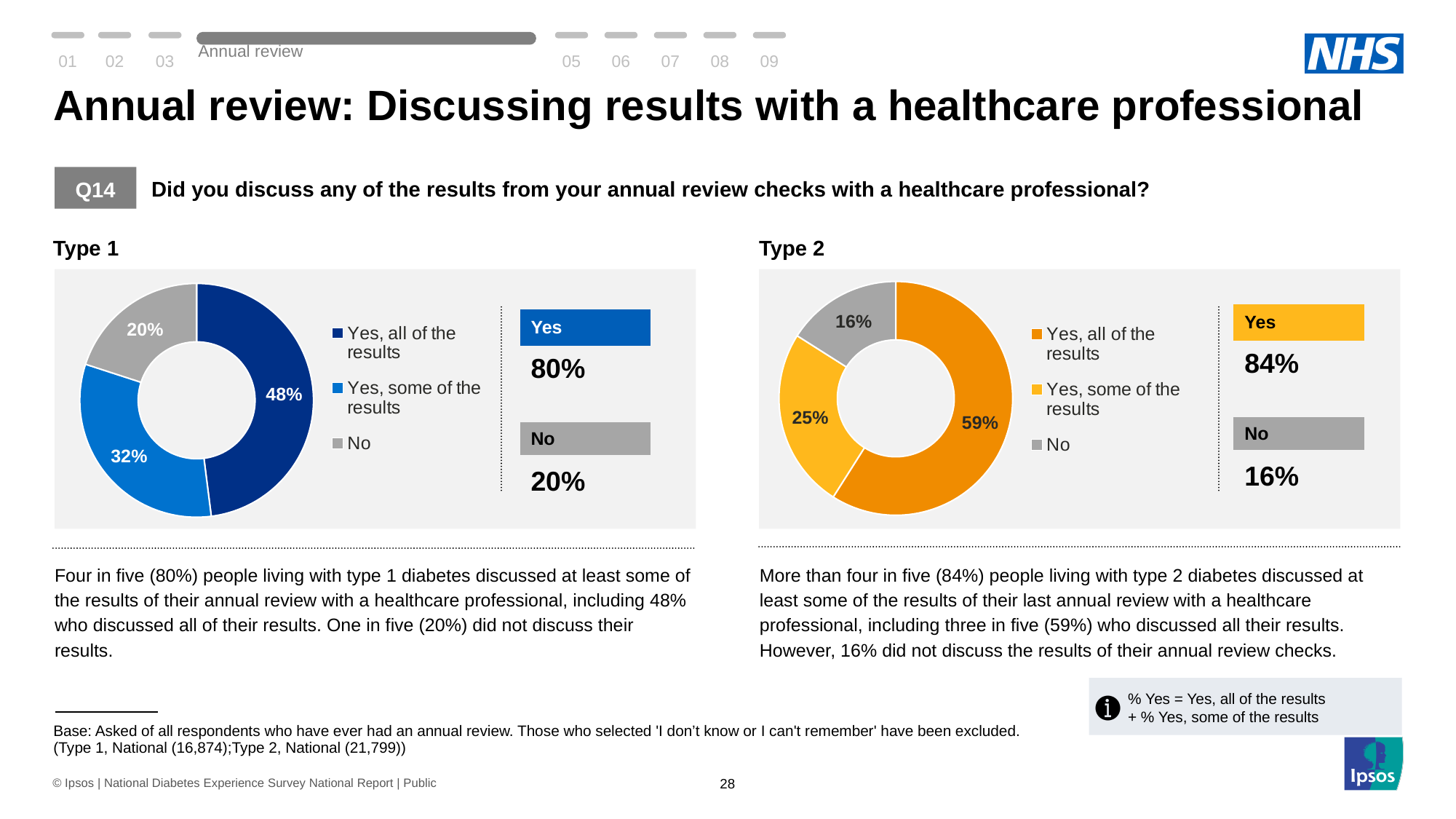
In the Type 1 chart, what percentage of respondents said 'No'? 20% In the Type 1 chart, which category has the smallest share? No What kind of chart is used for Type 2? Doughnut chart In the Type 2 chart, what percentage of respondents said 'Yes, some of the results'? 25% Which is larger: the 'No' share in the Type 1 chart or the 'No' share in the Type 2 chart? Type 1 In the Type 1 chart, what percentage of respondents said 'Yes, all of the results'? 48% In the Type 2 chart, which category has the largest share? Yes, all of the results In the Type 2 chart, what is the combined share of 'Yes, all of the results' and 'Yes, some of the results'? 84% How many entries does the legend of the Type 2 chart list? 3 How many categories does the Type 1 chart show? 3 In the Type 1 chart, what colour is the 'Yes, some of the results' segment? Light blue What is the difference between the 'Yes, all of the results' share in the Type 2 chart and the 'Yes, all of the results' share in the Type 1 chart? 11 percentage points